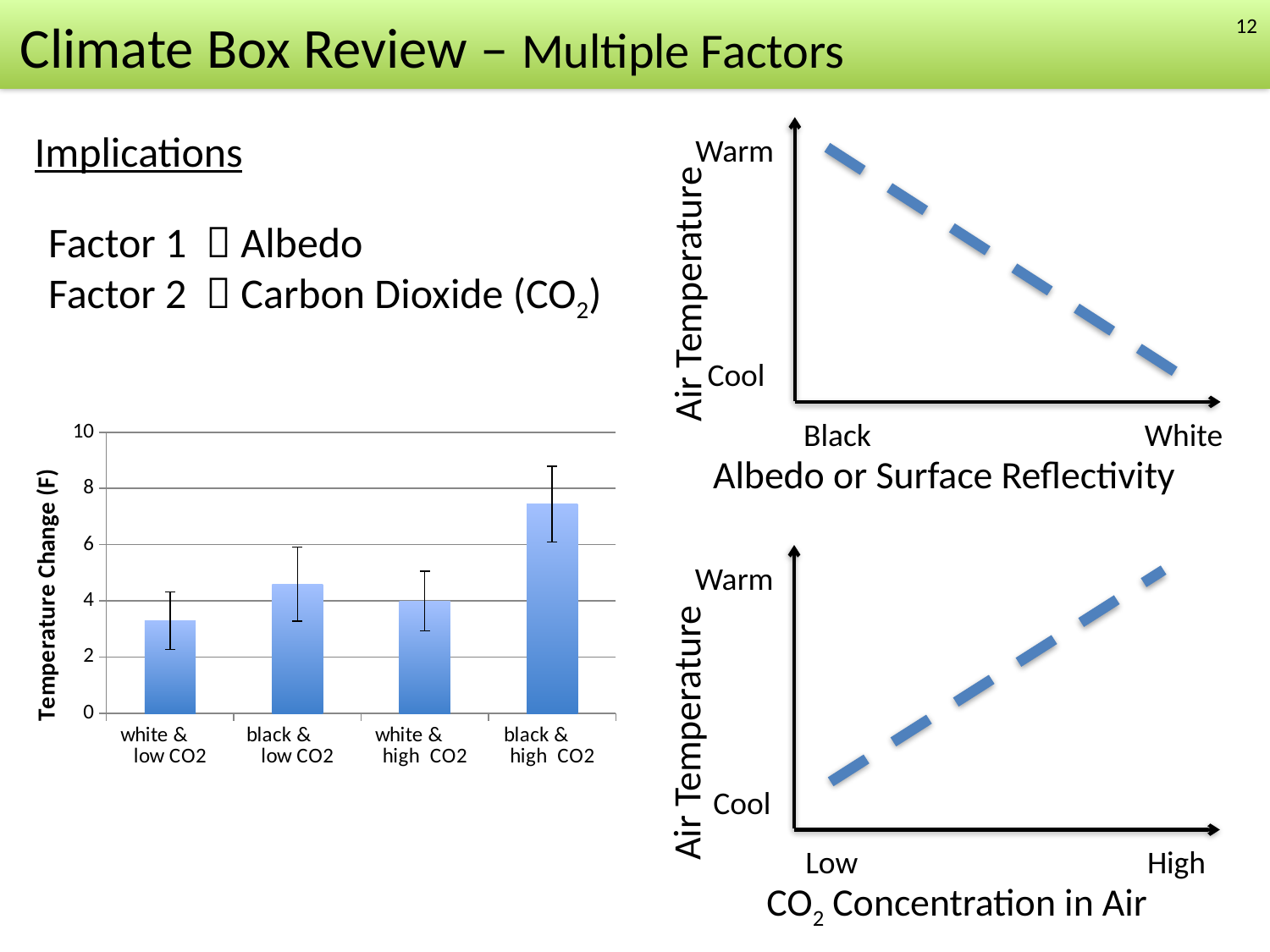
In the bar chart of Temperature Change (F), which is larger, the value for black & high CO2 or the value for white & low CO2? black & high CO2 In the bar chart of Temperature Change (F), which category has the lowest bar? white & low CO2 In the bar chart of Temperature Change (F), is the value for black & high CO2 greater or less than 6? greater In the bar chart of Temperature Change (F), is the value for white & low CO2 greater or less than 4? less What kind of chart is the chart in the bottom left of the slide showing Temperature Change (F)? bar chart In the bar chart of Temperature Change (F), how many categories are shown on the x axis? 4 In the bar chart of Temperature Change (F), which category has the highest bar? black & high CO2 In the bar chart of Temperature Change (F), is the value for black & low CO2 greater or less than 4? greater What is the y-axis title of the bar chart in the bottom left of the slide? Temperature Change (F) In the chart titled Albedo or Surface Reflectivity, does Air Temperature rise or fall as the x axis goes from Black to White? fall In the chart titled CO2 Concentration in Air, does Air Temperature rise or fall as the x axis goes from Low to High? rise In the bar chart of Temperature Change (F), which is larger, the value for black & high CO2 or the value for black & low CO2? black & high CO2